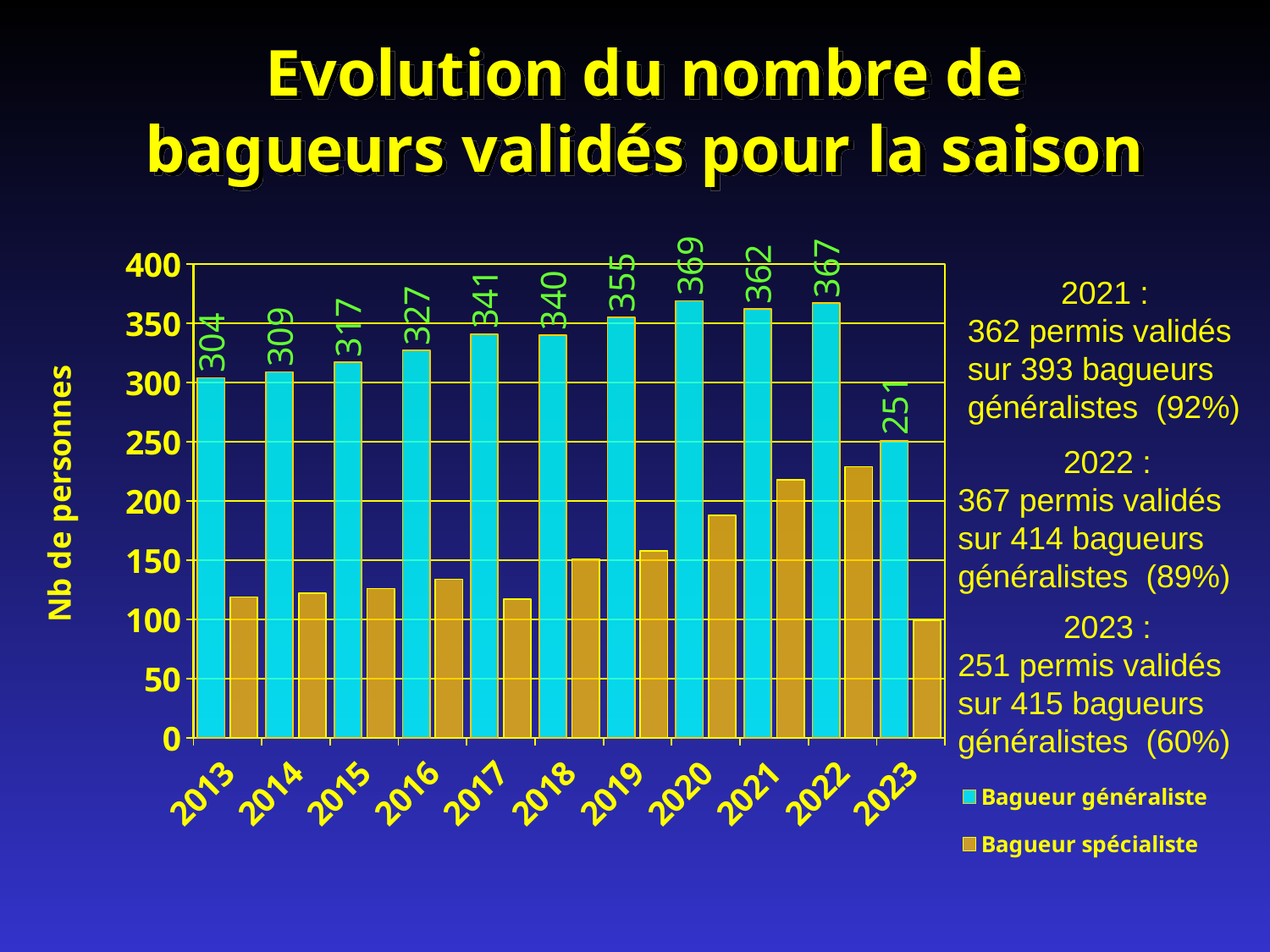
In which year is the Bagueur généraliste value highest? 2020 Which is larger, the Bagueur généraliste value for 2017 or for 2019? 2019 Is the value for Bagueur spécialiste in 2017 greater or less than 150? less How many years are shown on the x axis? 11 What is the value for Bagueur généraliste in 2023? 251 Is the value for Bagueur spécialiste in 2022 greater or less than 200? greater In which year is the Bagueur généraliste value lowest? 2023 What is the value for Bagueur généraliste in 2020? 369 What is the difference between the Bagueur généraliste values for 2022 and 2023? 116 What kind of chart is shown on the slide? Bar chart How many series does the legend list? 2 What is the value for Bagueur généraliste in 2013? 304